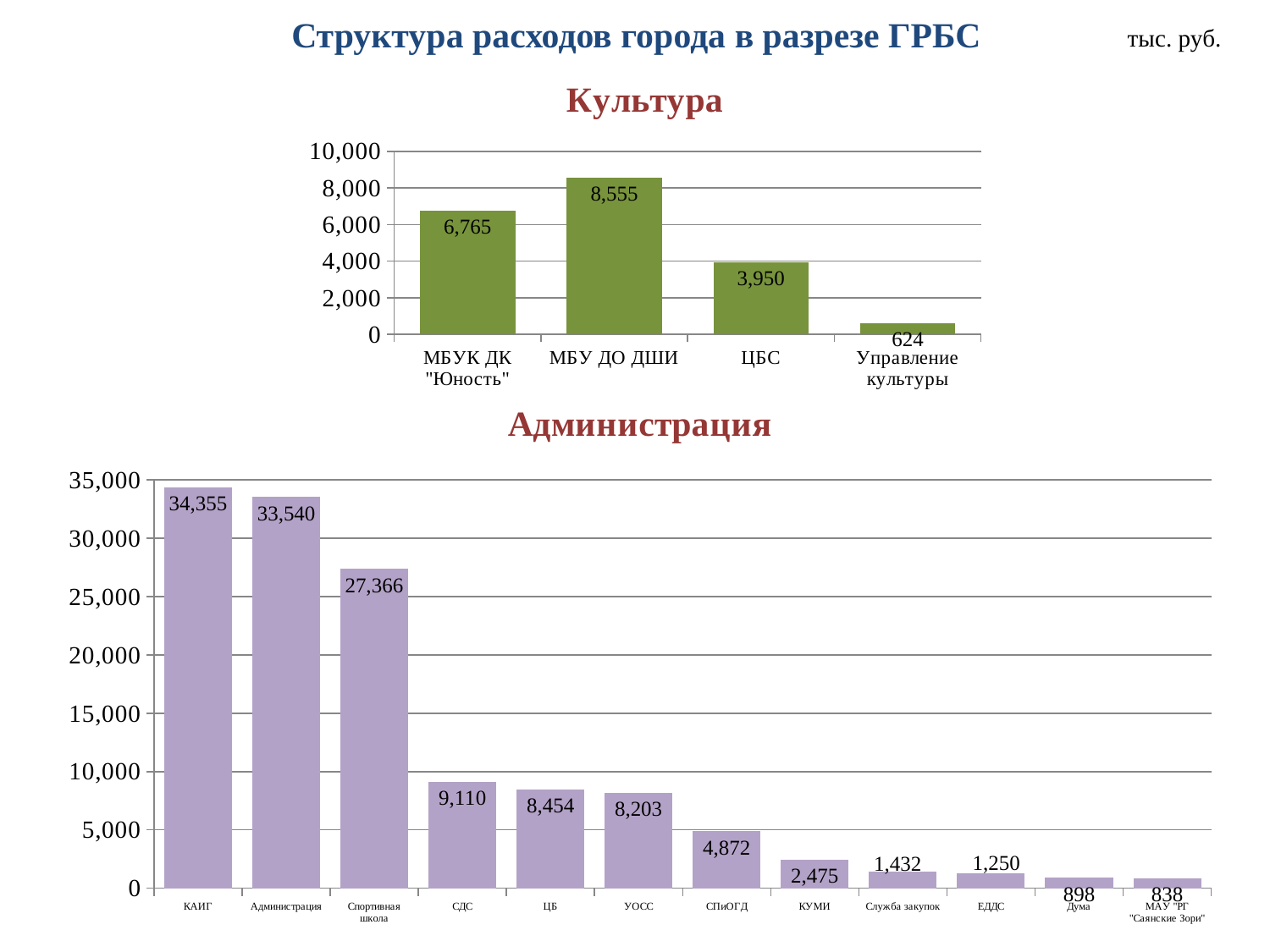
In the "Администрация" chart, what is the value for Спортивная школа? 27,366 In the "Администрация" chart, which category has the highest value? КАИГ In the "Администрация" chart, what is the difference between КАИГ and Администрация? 815 In the "Культура" chart, which category has the lowest value? Управление культуры In the "Культура" chart, what is the difference between МБУ ДО ДШИ and МБУК ДК "Юность"? 1,790 In the "Администрация" chart, how many categories are shown? 12 In the "Администрация" chart, which is larger: СДС or УОСС? СДС In the "Администрация" chart, do the values rise or fall from left to right? Fall In the "Культура" chart, how many categories are shown? 4 What type of chart is the "Администрация" chart? Bar chart In the "Администрация" chart, which category has the lowest value? МАУ "РГ "Саянские Зори" In the "Культура" chart, what is the value for МБУ ДО ДШИ? 8,555